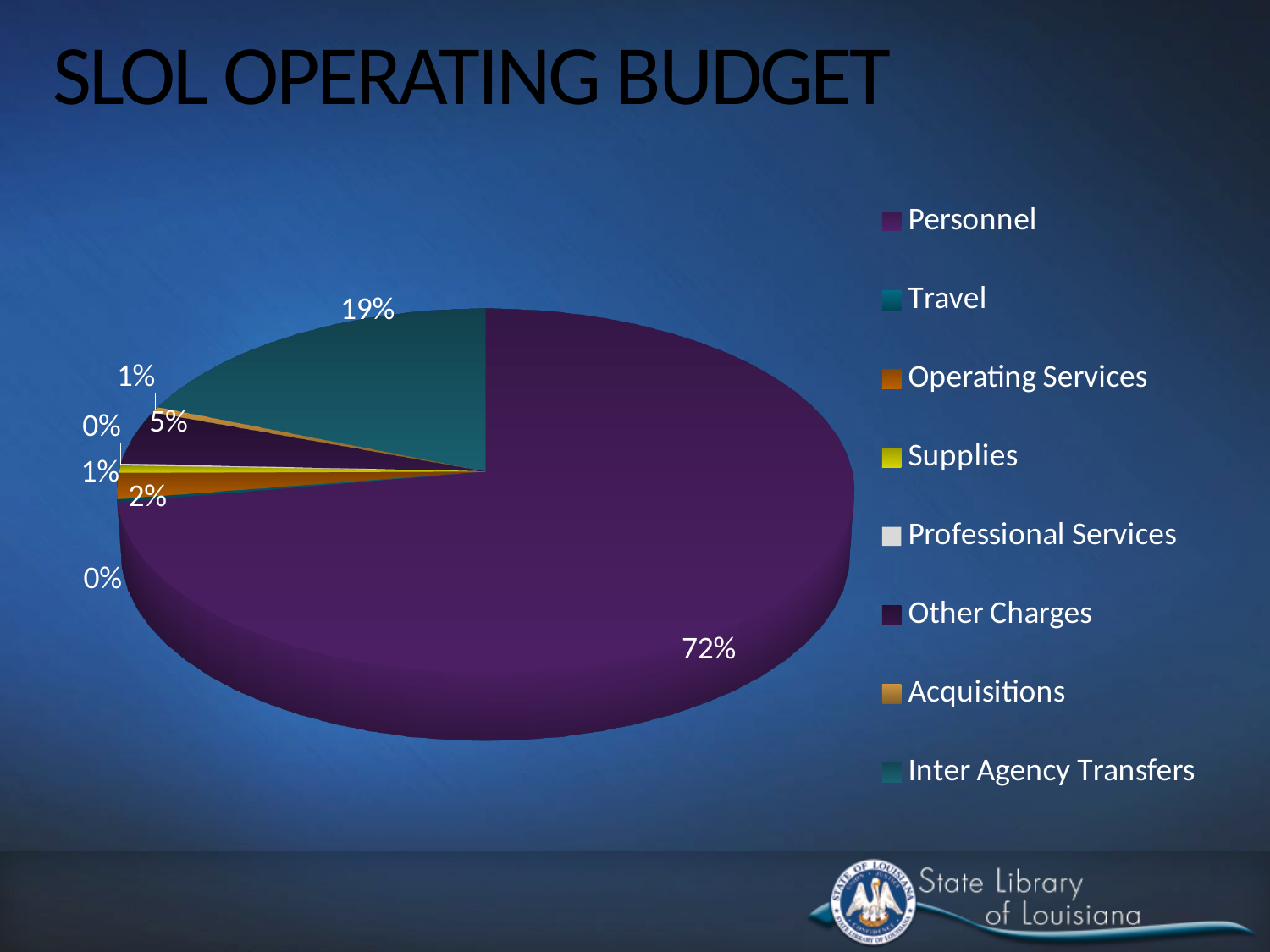
What is the difference in percentage points between the Personnel share and the Inter Agency Transfers share? 53 percentage points What kind of chart is shown on the slide? Pie chart What share of the SLOL operating budget goes to Inter Agency Transfers? 19% What share of the SLOL operating budget goes to Personnel? 72% How many categories does the legend list? 8 Which is larger, the share for Personnel or the share for Inter Agency Transfers? Personnel What is the title of the chart on the slide? SLOL OPERATING BUDGET What share of the SLOL operating budget goes to Operating Services? 2% Which legend entry is shown in the largest purple slice of the pie? Personnel Which category has the largest share of the SLOL operating budget? Personnel Which is larger, the share for Other Charges or the share for Operating Services? Other Charges